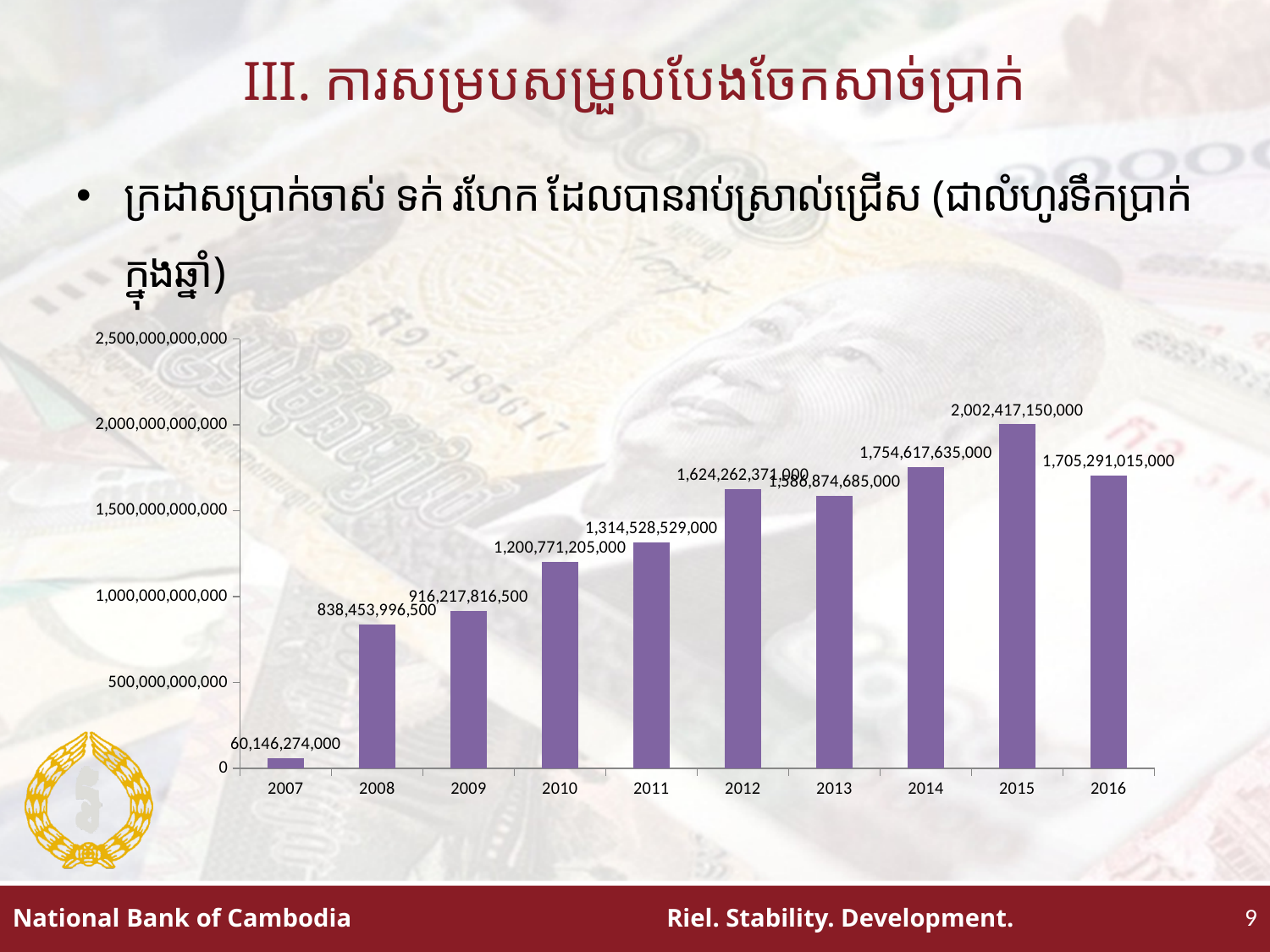
Do the values rise or fall from 2007 to 2012? rise Which year has the larger value, 2014 or 2016? 2014 What is the value for 2007? 60,146,274,000 How many years are shown on the x axis of the chart? 10 What is the value for 2008? 838,453,996,500 Which year has the lowest value in the chart? 2007 Which year has the highest value in the chart? 2015 Is the value for 2013 greater or less than 1,500,000,000,000? greater What is the value for 2015? 2,002,417,150,000 What kind of chart is shown on the slide? bar chart What is the value for 2016? 1,705,291,015,000 What is the difference between the values for 2015 and 2016? 297,126,135,000